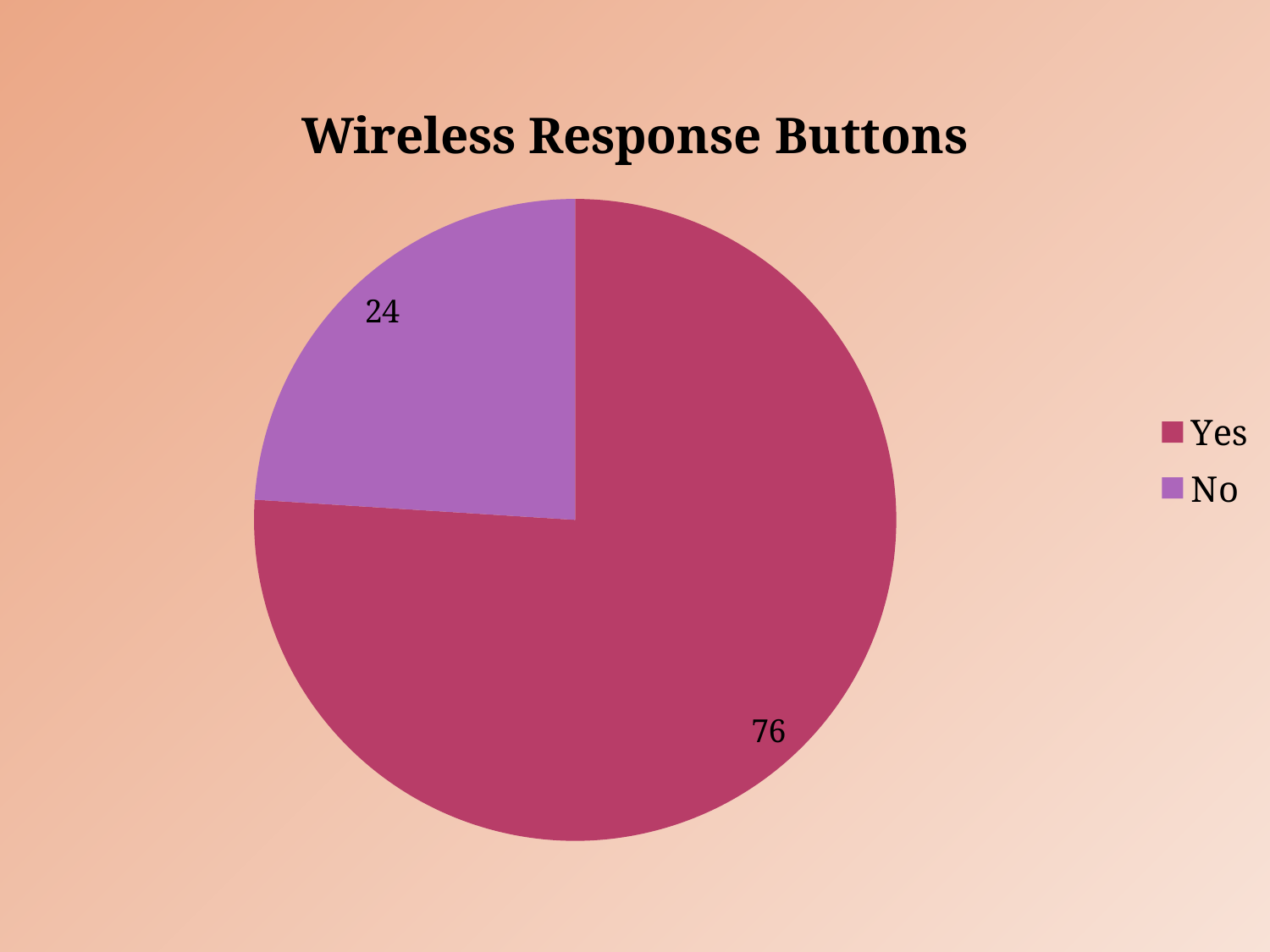
What share of the pie does the No slice represent? 24% What is the value for No? 24 What is the value for Yes? 76 Which category has the smallest slice? No What is the difference between the values for Yes and No? 52 Which is larger, the value for Yes or the value for No? Yes What is the total of the two slices? 100 What is the title of the chart? Wireless Response Buttons What kind of chart is shown on the slide? pie chart How many slices does the pie chart have? 2 How many entries does the legend list? 2 Which category has the largest slice? Yes